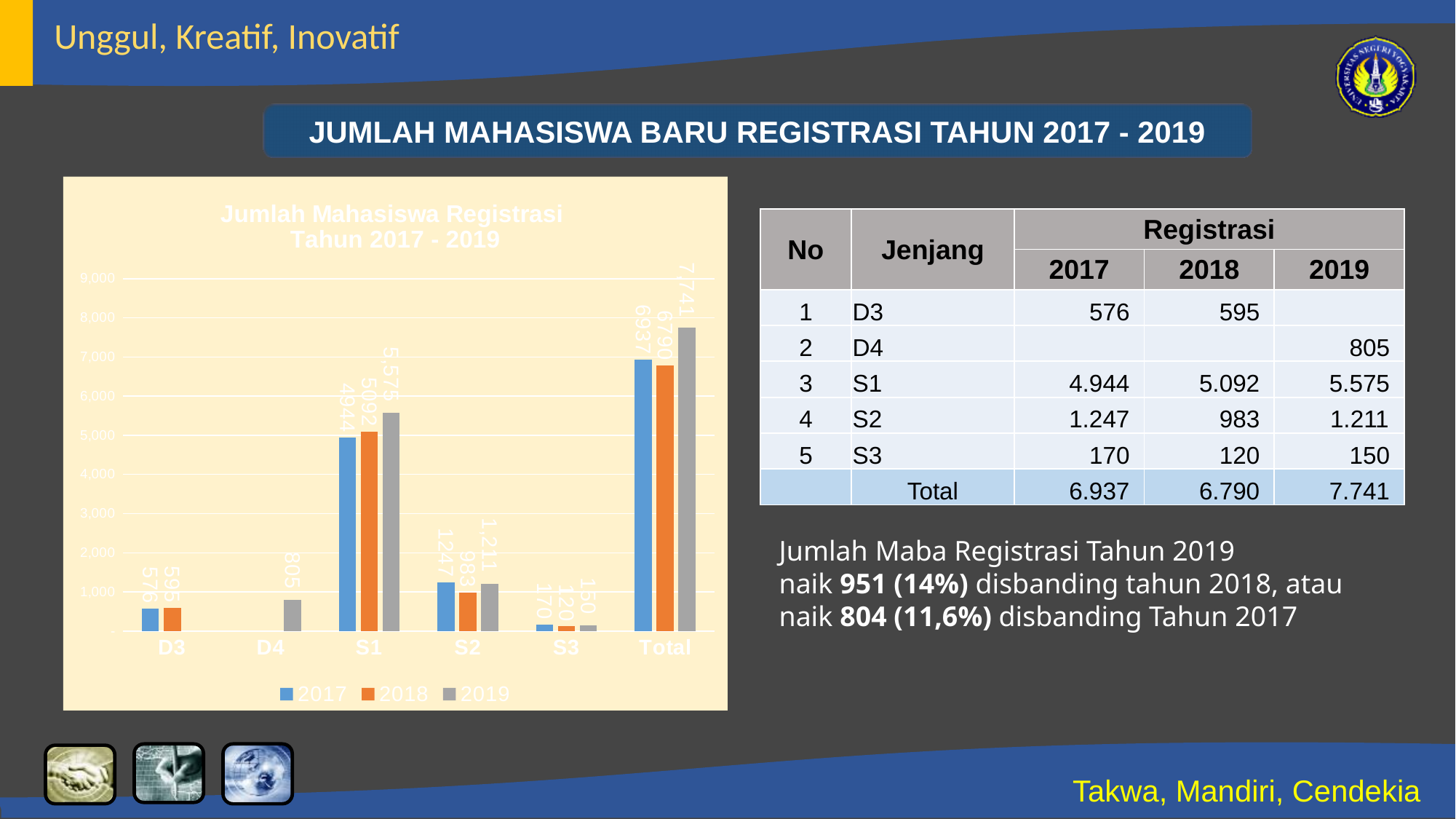
How many categories are shown on the x axis of the chart? 6 What is the title of the chart? Jumlah Mahasiswa Registrasi Tahun 2017 - 2019 Which is larger for S2: the 2017 value or the 2018 value? 2017 What type of chart is shown on the slide? bar chart Excluding Total, which category has the lowest value in the 2019 series? S3 What is the value for D4 in the 2019 series? 805 Is the 2019 value for Total greater or less than 7,000? greater What is the value for S3 in the 2018 series? 120 What is the value for S1 in the 2019 series? 5.575 How many series does the chart legend list? 3 Which category has the highest value in the 2017 series? Total What is the difference between the 2019 and 2018 values for S3? 30